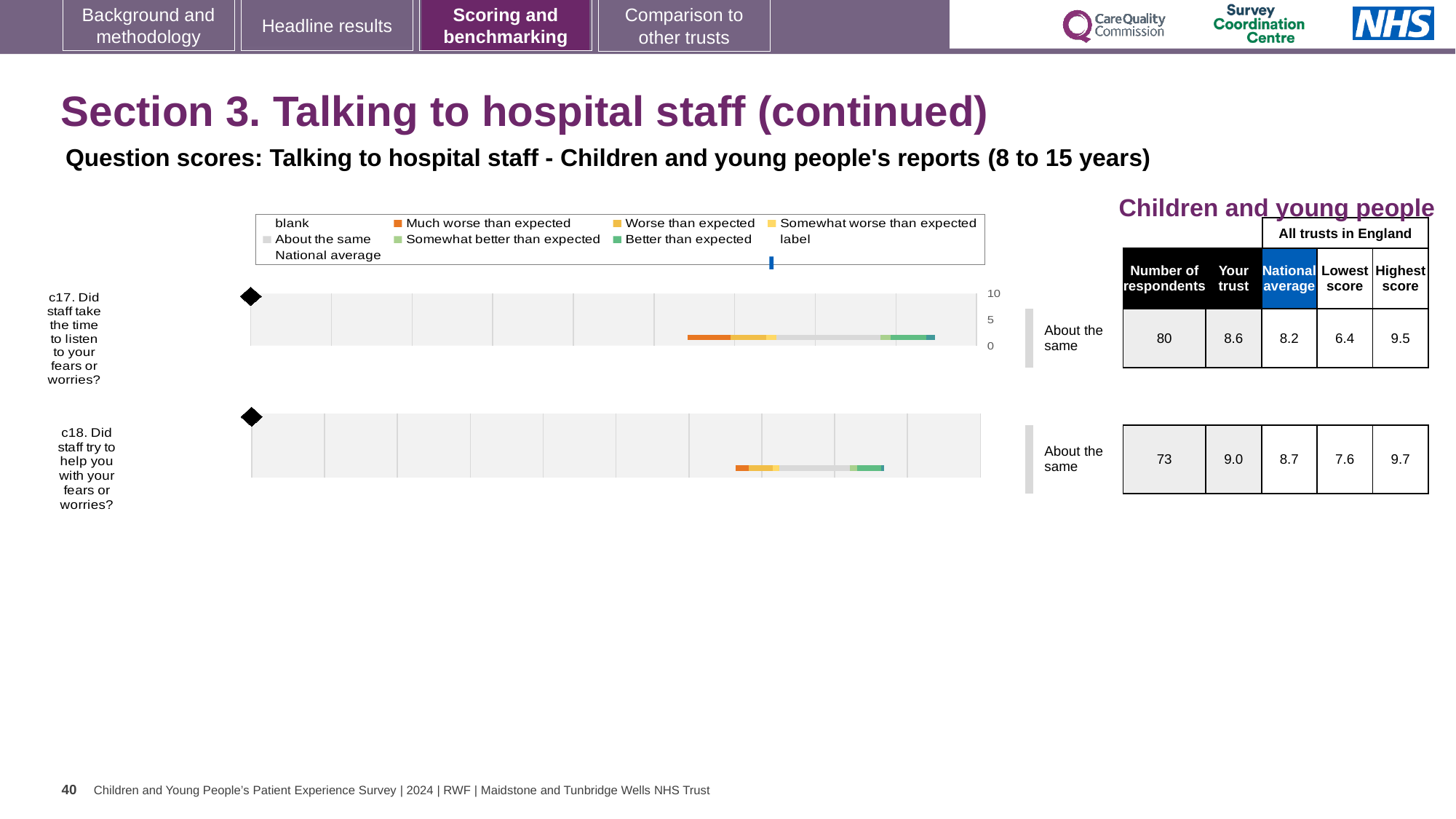
What is the difference between the highest and lowest scores across all trusts for question c18? 2.1 What is the 'Your trust' score for question c18 (Did staff try to help you with your fears or worries?)? 9.0 What is the national average score for question c17? 8.2 What is the highest score across all trusts in England for question c18? 9.7 What benchmark category is shown for question c17? About the same What is the lowest score across all trusts in England for question c17? 6.4 Which question has the higher 'Your trust' score, c17 or c18? c18 By how much does the trust's score for c17 exceed the national average for c17? 0.4 What is the 'Your trust' score for question c17 (Did staff take the time to listen to your fears or worries?)? 8.6 How many respondents answered question c18? 73 How many questions are plotted on this slide? 2 What kind of chart is used to show the question scores on this slide? Bar chart